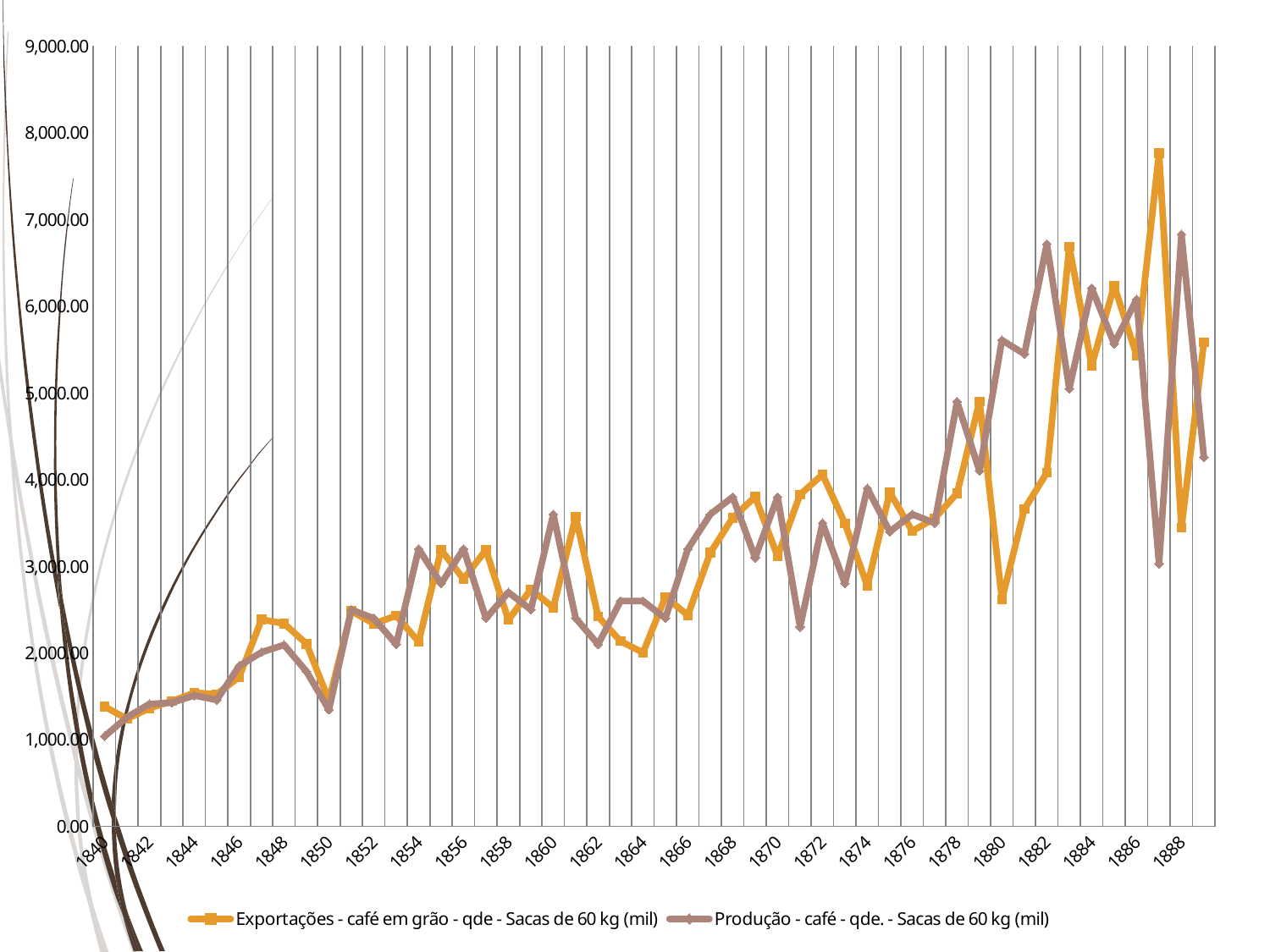
Overall, do the Exportações values rise or fall from 1840 to the end of the series? rise Is the Exportações value for 1880 greater or less than 3,000.00? less Is the Produção value for 1882 greater or less than 6,000.00? greater What kind of chart is shown on the slide? line chart In which year does the Exportações series reach its highest value? 1887 How many series does the legend list? 2 What colour is the line for the Exportações series? orange Is the Exportações value for 1887 greater or less than 7,000.00? greater In 1880, which series has the larger value, Exportações or Produção? Produção What is the highest value shown on the vertical axis? 9,000.00 In 1887, which series has the larger value, Exportações or Produção? Exportações